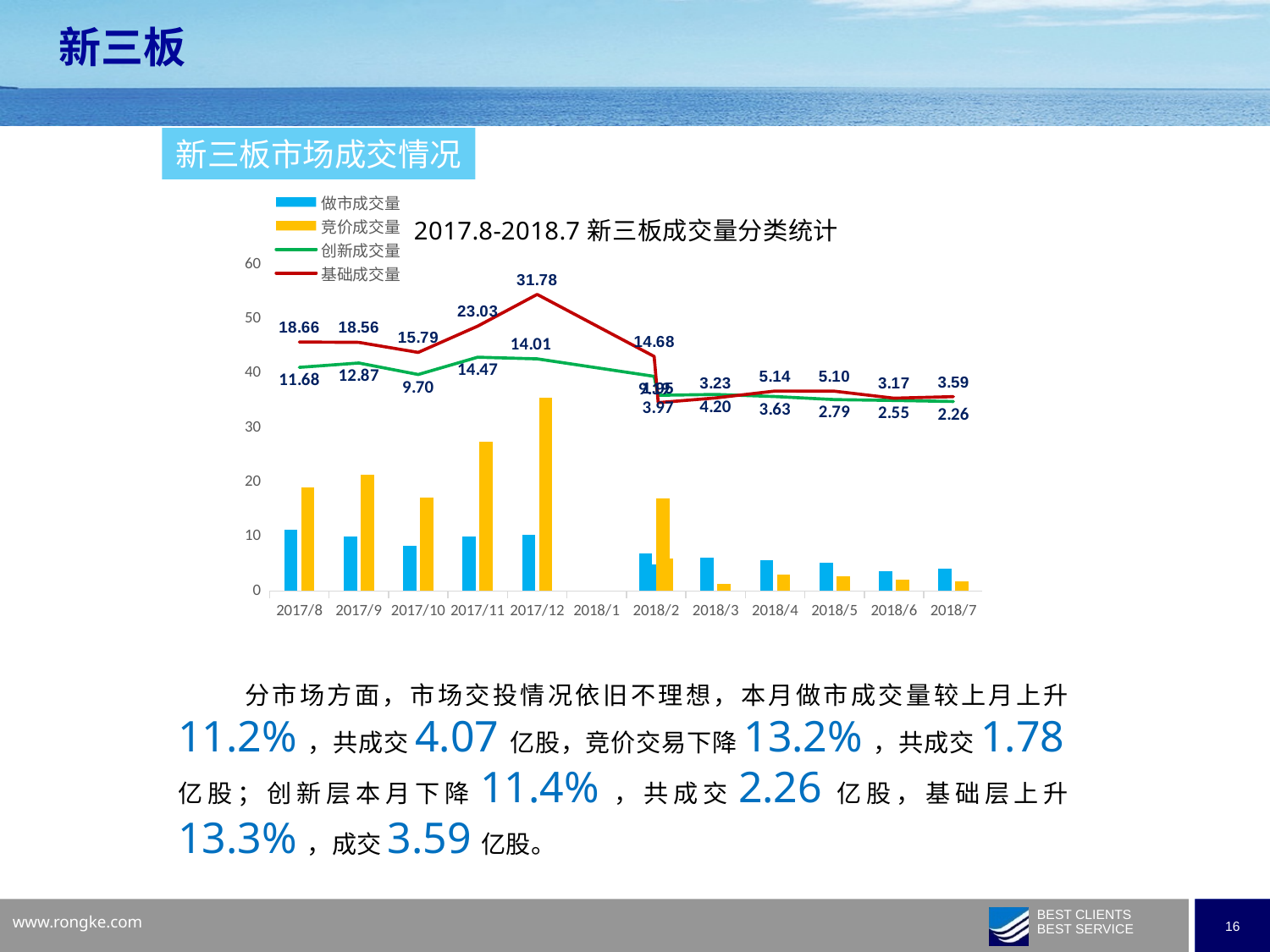
In 2017/9, which is larger: 基础成交量 or 创新成交量? 基础成交量 What is the value of 基础成交量 for 2018/7? 3.59 What is the title of the chart? 2017.8-2018.7 新三板成交量分类统计 In which month is 创新成交量 lowest? 2018/7 What is the difference between 基础成交量 in 2017/11 and 2017/10? 7.24 Is the 竞价成交量 bar for 2018/3 greater or less than 10? less How many series does the chart legend list? 4 In which month is 基础成交量 highest? 2017/12 Is the 竞价成交量 bar for 2017/12 greater or less than 30? greater What is the value of 基础成交量 for 2017/12? 31.78 What is the value of 创新成交量 for 2018/7? 2.26 What kind of chart is shown on the slide? A combined bar and line chart